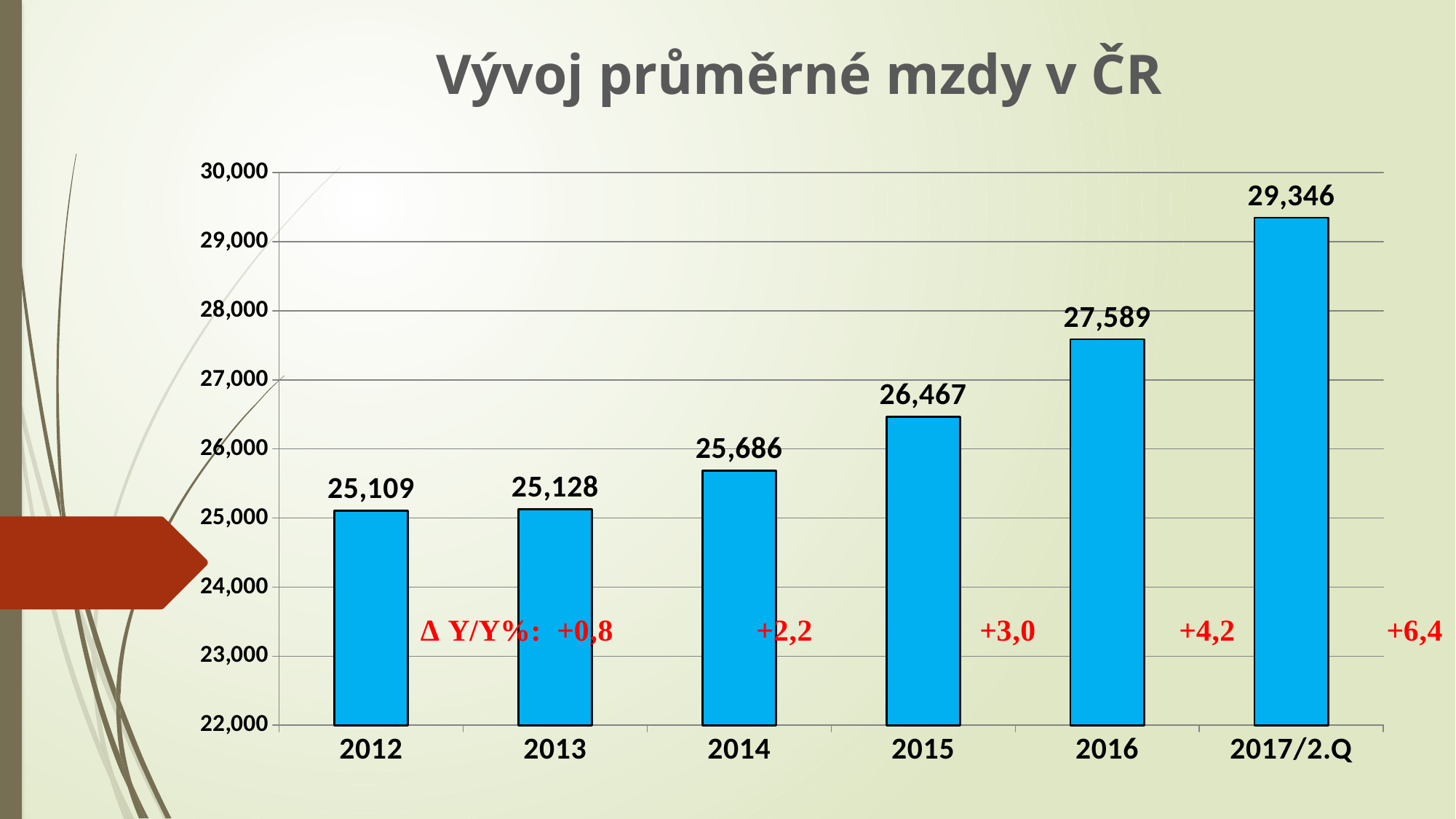
How many categories are shown on the x axis? 6 What is the value for 2017/2.Q? 29,346 What is the value for 2016? 27,589 What type of chart is shown on the slide? bar chart What is the value for 2014? 25,686 What is the difference between the values for 2017/2.Q and 2012? 4,237 Which is larger, the value for 2015 or the value for 2014? 2015 Do the values rise or fall from 2012 to 2017/2.Q? rise What is the title of the chart? Vývoj průměrné mzdy v ČR Which category has the lowest value? 2012 Which category has the highest value? 2017/2.Q What is the difference between the values for 2016 and 2015? 1,122